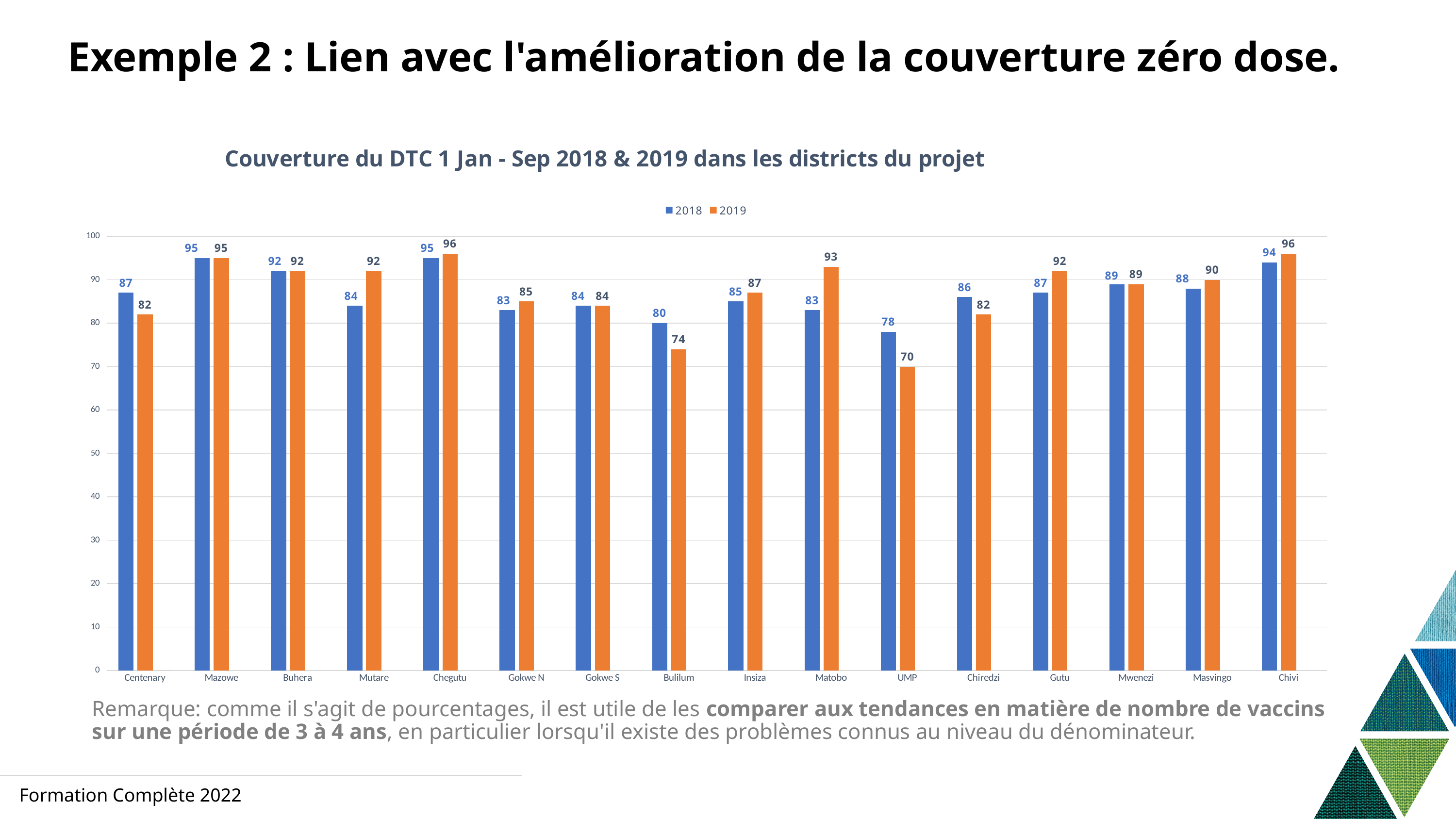
What is the difference between the 2018 and 2019 values for Centenary? 5 What kind of chart is shown on the slide? Bar chart What is the 2019 value for Bulilum? 74 For Chiredzi, which is larger: the 2018 value or the 2019 value? 2018 Which district has the lowest 2018 value? UMP Which district has the lowest 2019 value? UMP What is the 2018 value for Matobo? 83 For Gutu, which is larger: the 2018 value or the 2019 value? 2019 What is the 2019 value for Mutare? 92 What is the difference between the 2019 and 2018 values for Matobo? 10 How many series does the legend list? 2 How many districts are shown on the x axis? 16